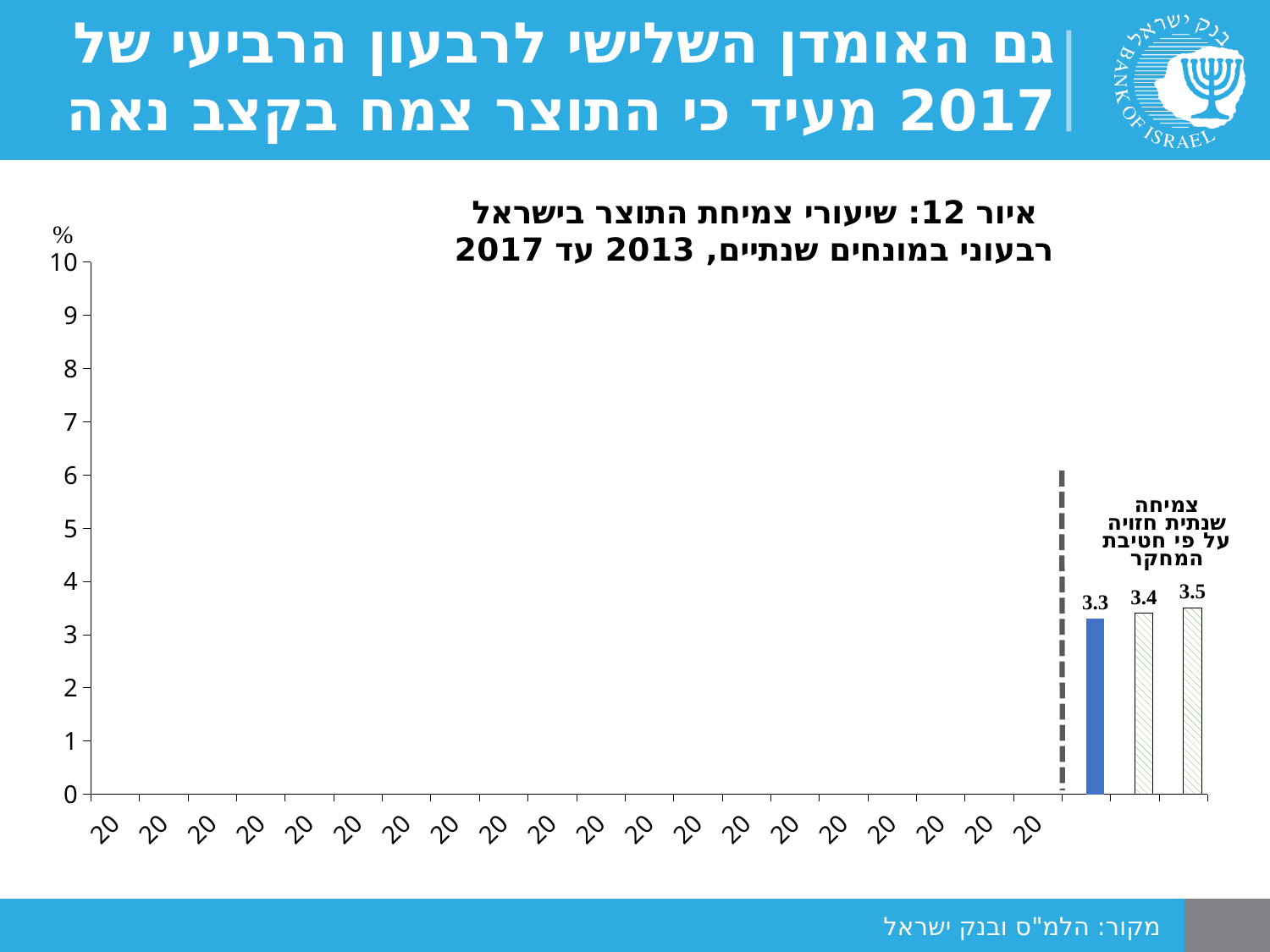
What is the value shown on the rightmost hatched bar? 3.5 What is the value shown on the middle (first hatched) bar of the three labelled bars? 3.4 What unit is indicated at the top of the vertical axis? % What is the difference between the rightmost bar (3.5) and the solid blue bar (3.3)? 0.2 Do the values of the three labelled bars rise or fall from left to right? rise What kind of chart is shown on the slide? bar chart What is the value shown on the solid blue bar? 3.3 How many bars on the chart have data labels? 3 What is the maximum value shown on the vertical axis? 10 Which of the three labelled bars has the highest value? the rightmost bar (3.5) Which of the three labelled bars has the lowest value? the solid blue bar (3.3) Is the value of the solid blue bar greater or less than 4? less